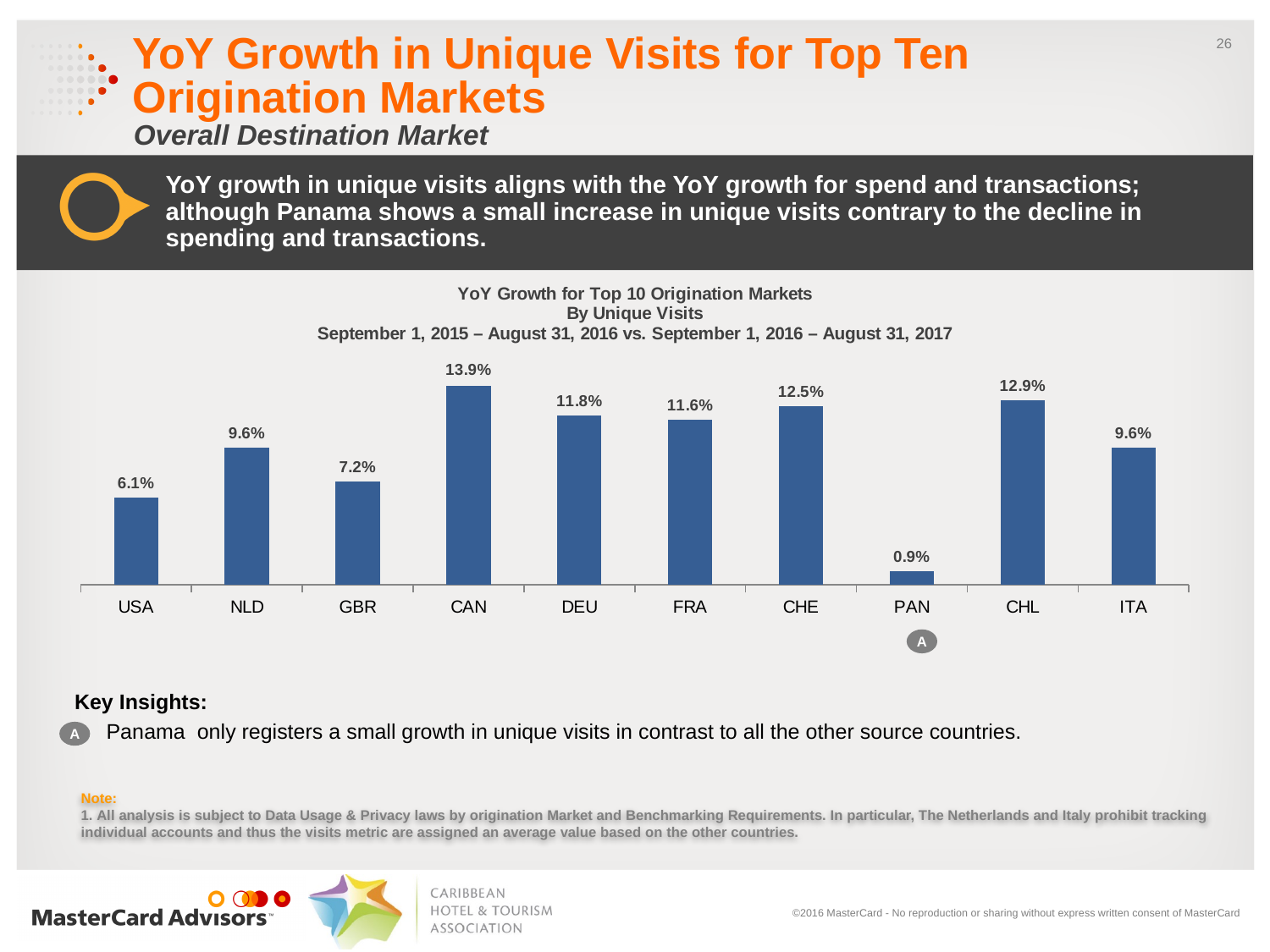
What is the YoY growth in unique visits for CAN? 13.9% Which two origination markets both show a YoY growth of 9.6%? NLD and ITA What is the difference between the YoY growth for CAN and the YoY growth for PAN? 13.0% Which has a higher YoY growth in unique visits, DEU or FRA? DEU What kind of chart is used to show YoY growth for the top 10 origination markets? Bar chart What is the YoY growth in unique visits for PAN? 0.9% Which origination market has the lowest YoY growth in unique visits? PAN What is the YoY growth in unique visits for USA? 6.1% What is the title of the chart? YoY Growth for Top 10 Origination Markets By Unique Visits September 1, 2015 – August 31, 2016 vs. September 1, 2016 – August 31, 2017 How many origination markets are shown on the chart? 10 What is the difference between the YoY growth for CHL and the YoY growth for GBR? 5.7% Which origination market has the highest YoY growth in unique visits? CAN